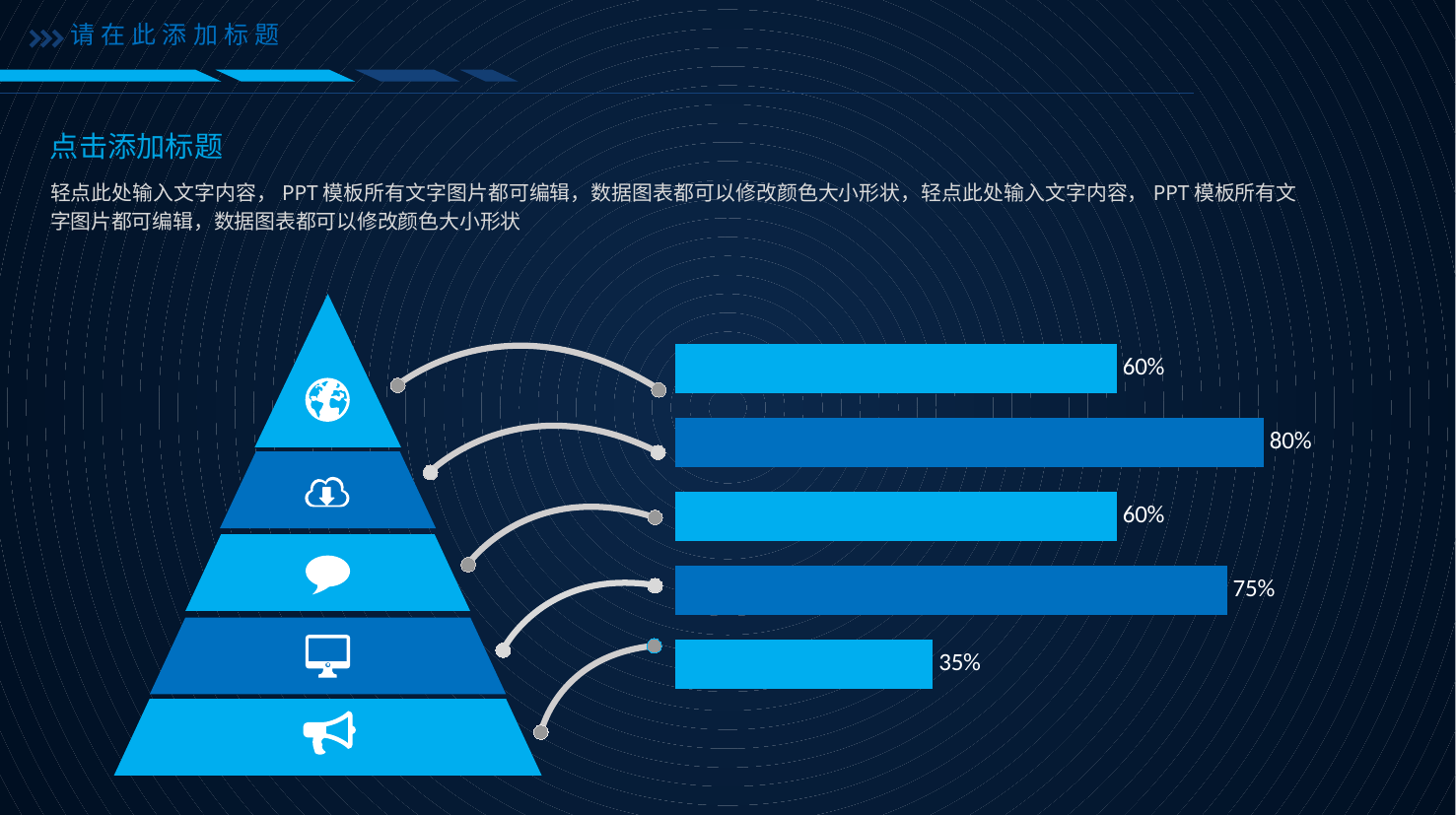
Which is larger, the value of the fourth bar or the value of the bottom bar? The fourth bar (75%) Which bar has the highest value? The second bar from the top (80%) What kind of chart is shown on the right side of the slide? Bar chart How many bars are shown in the chart? 5 What is the value shown on the fourth bar from the top? 75% What is the value shown on the bottom bar of the bar chart? 35% How many levels does the pyramid on the left of the slide have? 5 What is the value shown on the top bar of the bar chart? 60% What is the difference between the second bar (80%) and the fourth bar (75%)? 5% Which bar has the lowest value? The bottom bar (35%) What is the value shown on the second bar from the top? 80% What is the difference between the highest bar value and the lowest bar value? 45%